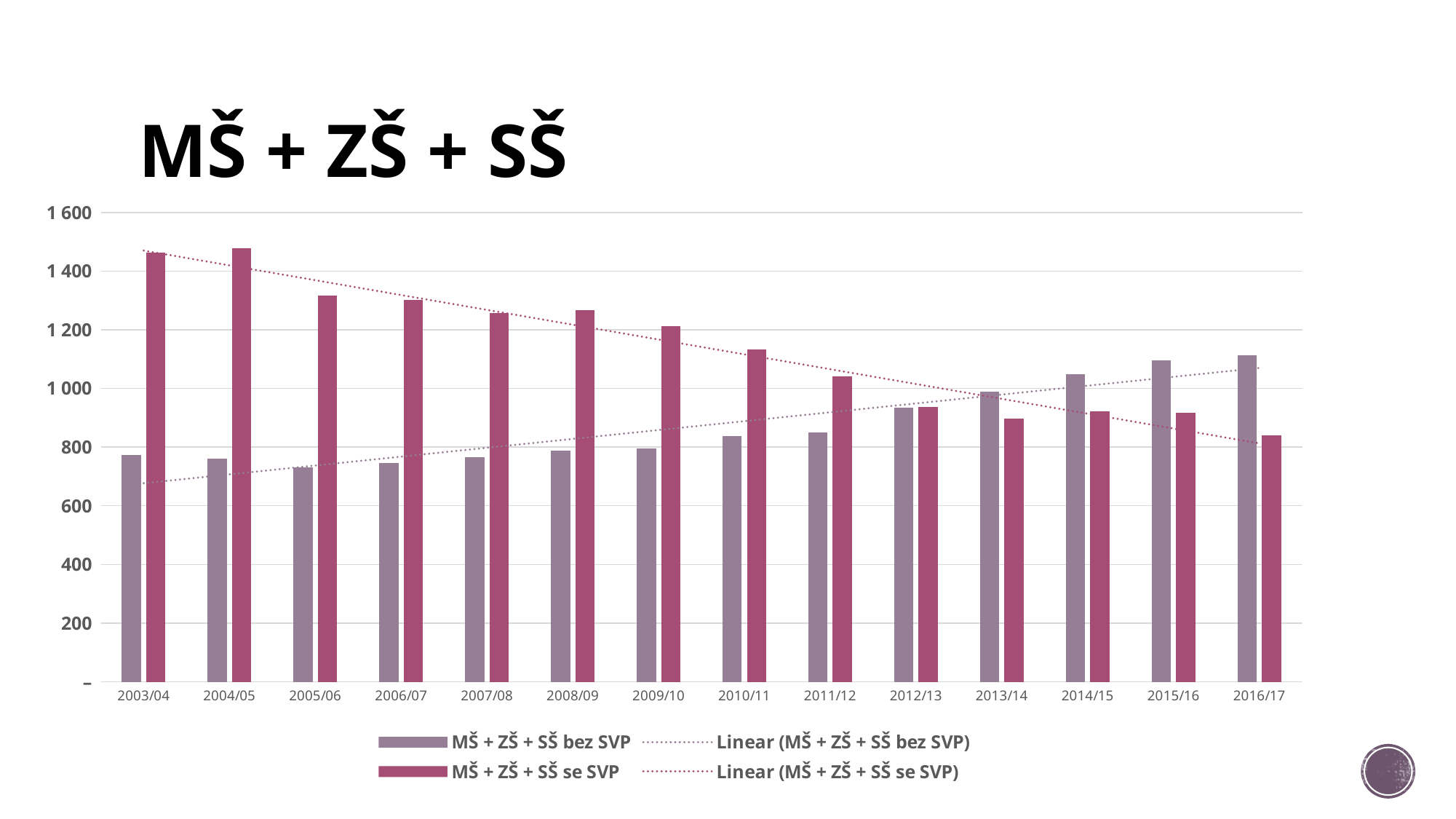
Is the value for 'MŠ + ZŠ + SŠ se SVP' in 2003/04 greater or less than 1 400? greater Which school year has the lowest value for 'MŠ + ZŠ + SŠ se SVP'? 2016/17 Is the value for 'MŠ + ZŠ + SŠ se SVP' in 2013/14 greater or less than 1 000? less What is the title of the chart? MŠ + ZŠ + SŠ Do the values for 'MŠ + ZŠ + SŠ se SVP' generally rise or fall from 2003/04 to 2016/17? fall In 2016/17, which series has the larger value: 'MŠ + ZŠ + SŠ bez SVP' or 'MŠ + ZŠ + SŠ se SVP'? MŠ + ZŠ + SŠ bez SVP Is the value for 'MŠ + ZŠ + SŠ bez SVP' in 2005/06 greater or less than 800? less How many entries does the legend list? 4 In 2003/04, which series has the larger value: 'MŠ + ZŠ + SŠ bez SVP' or 'MŠ + ZŠ + SŠ se SVP'? MŠ + ZŠ + SŠ se SVP What kind of chart is shown on the slide? bar chart How many school years are shown on the x axis? 14